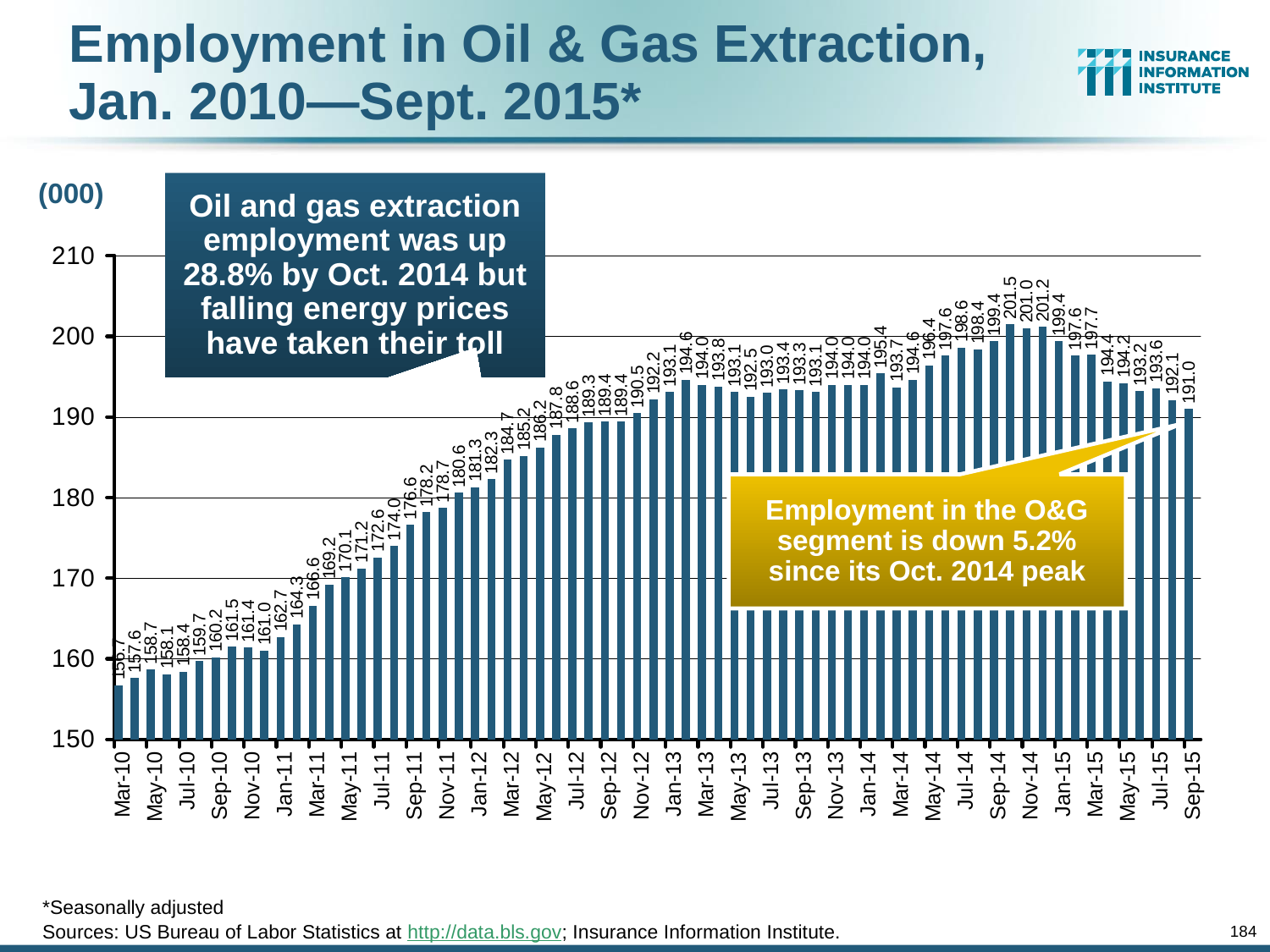
Which is larger, the value for Sep-15 or the value for Mar-10? Sep-15 What kind of chart is shown on the slide? bar chart What is the employment value for Sep-15? 191.0 Which month is the lowest bar on the chart? Mar-10 What is the employment value for Mar-10, the first bar? 156.7 What is the highest value shown on the chart? 201.5 According to the callout, by what percentage is employment in the O&G segment down since its Oct. 2014 peak? 5.2% What is the employment value for Jan-15? 199.4 What is the difference between the Sep-15 value and the Mar-10 value? 34.3 Do the values generally rise or fall from Mar-10 to Oct-14? rise What is the difference between the peak value of 201.5 and the Sep-15 value of 191.0? 10.5 Is the value for Mar-15 greater or less than 200? less